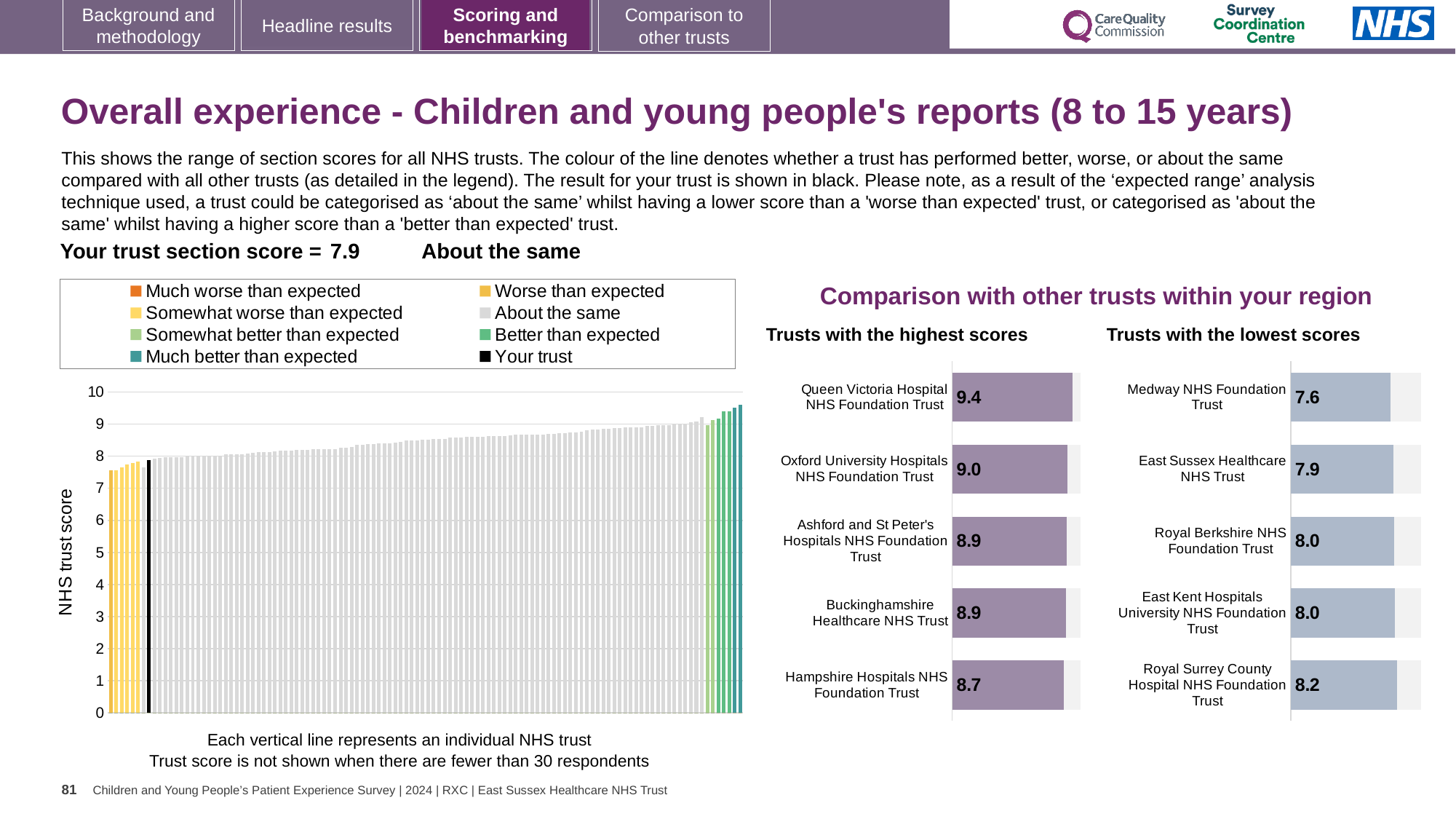
In the 'Trusts with the lowest scores' chart, what is the score for East Sussex Healthcare NHS Trust? 7.9 In the 'Trusts with the highest scores' chart, which trust has the highest score? Queen Victoria Hospital NHS Foundation Trust In the 'Trusts with the highest scores' chart, what is the difference between the scores of Queen Victoria Hospital NHS Foundation Trust and Hampshire Hospitals NHS Foundation Trust? 0.7 In the 'Trusts with the highest scores' chart, what is the score for Queen Victoria Hospital NHS Foundation Trust? 9.4 How many entries does the legend above the large 'NHS trust score' chart list? 8 What kind of chart is the large 'NHS trust score' chart on the left of the slide? Bar chart In the 'Trusts with the lowest scores' chart, which trust has the lowest score? Medway NHS Foundation Trust In the 'Trusts with the lowest scores' chart, what is the score for Medway NHS Foundation Trust? 7.6 How many trusts are listed in the 'Trusts with the highest scores' chart? 5 In the large 'NHS trust score' chart on the left, do the bar heights rise or fall from left to right? Rise In the 'Trusts with the lowest scores' chart, what is the difference between the scores of Royal Surrey County Hospital NHS Foundation Trust and Medway NHS Foundation Trust? 0.6 Which is larger: the score for Oxford University Hospitals NHS Foundation Trust in the highest scores chart, or the score for Royal Surrey County Hospital NHS Foundation Trust in the lowest scores chart? Oxford University Hospitals NHS Foundation Trust